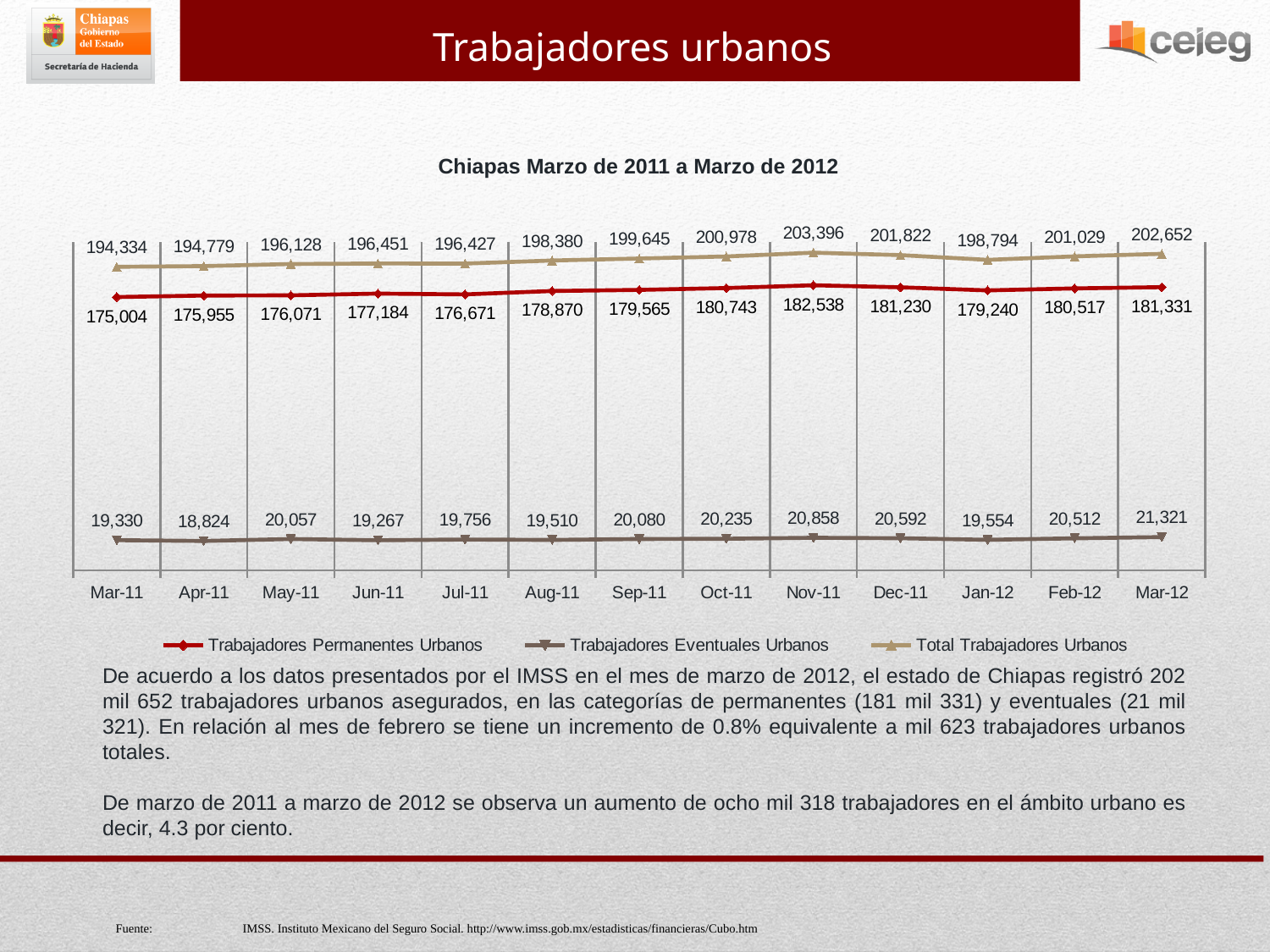
Does Total Trabajadores Urbanos overall rise or fall from Mar-11 to Mar-12? Rise What is the value of Total Trabajadores Urbanos in Nov-11? 203,396 What type of chart is shown on the slide? Line chart How many months are plotted along the x axis? 13 What is the difference between Total Trabajadores Urbanos in Mar-12 and Mar-11? 8,318 What is the value of Trabajadores Eventuales Urbanos in Mar-12? 21,321 How many series does the legend list? 3 In which month is Trabajadores Eventuales Urbanos lowest? Apr-11 In which month is Total Trabajadores Urbanos highest? Nov-11 Which is larger for Trabajadores Eventuales Urbanos: May-11 or Jun-11? May-11 What is the title of the chart? Chiapas Marzo de 2011 a Marzo de 2012 What is the value of Trabajadores Permanentes Urbanos in Jun-11? 177,184